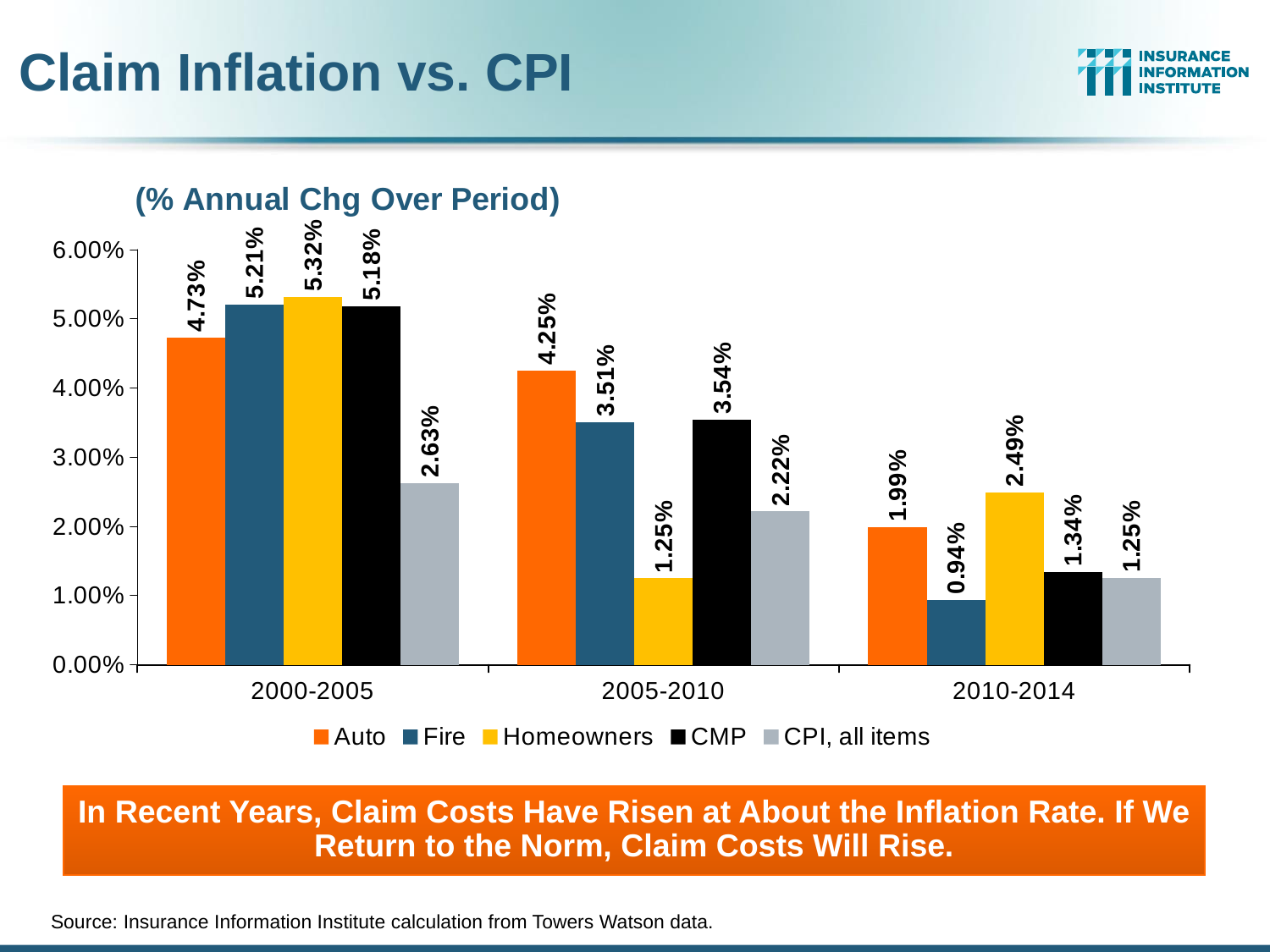
Which is larger in the 2005-2010 period, Fire or CMP? CMP What is the value for Auto in the 2000-2005 period? 4.73% How many periods are shown on the x axis? 3 Which series has the highest value in the 2000-2005 period? Homeowners Which series has the lowest value in the 2010-2014 period? Fire What is the value for Homeowners in the 2005-2010 period? 1.25% What kind of chart is shown on the slide? bar chart Is the value for CMP in the 2010-2014 period greater or less than 2.00%? less Does the Auto value rise or fall across the periods from 2000-2005 to 2010-2014? fall What is the difference between the Auto value and the CPI, all items value in the 2005-2010 period? 2.03% What is the value for CPI, all items in the 2010-2014 period? 1.25% How many series does the legend list? 5